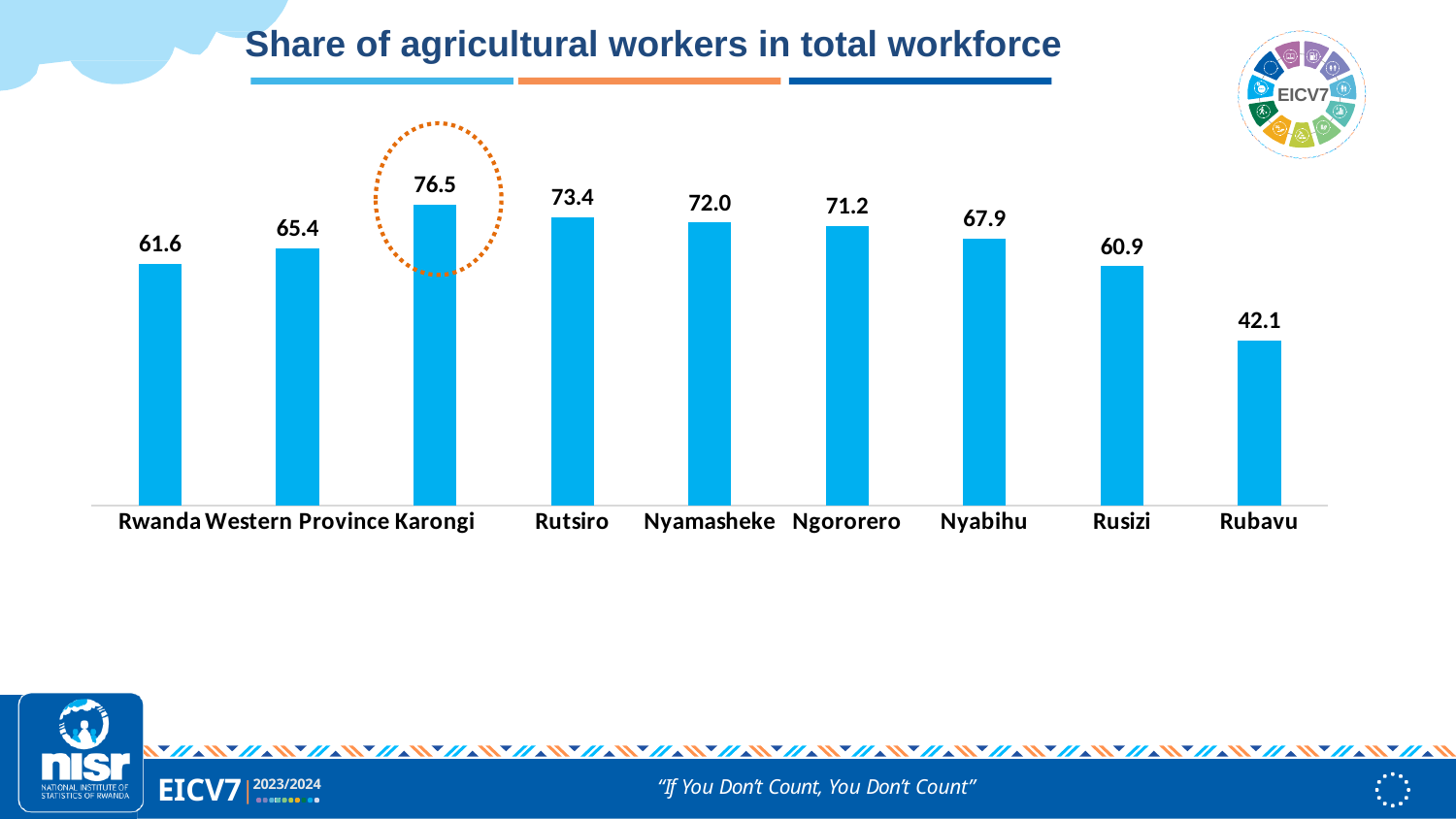
What is the difference between the values for Karongi and Rubavu? 34.4 What is the value shown for Western Province? 65.4 How many categories are shown on the x axis? 9 Which bar is highlighted with a dotted orange circle? Karongi What kind of chart is shown on the slide? Bar chart What is the difference between the values for Western Province and Rwanda? 3.8 What is the value shown for Rubavu? 42.1 Which category has the highest share of agricultural workers? Karongi What is the value shown for Rwanda? 61.6 Which has a larger value, Rutsiro or Nyabihu? Rutsiro What is the share of agricultural workers in the total workforce for Karongi? 76.5 Which category has the lowest share of agricultural workers? Rubavu